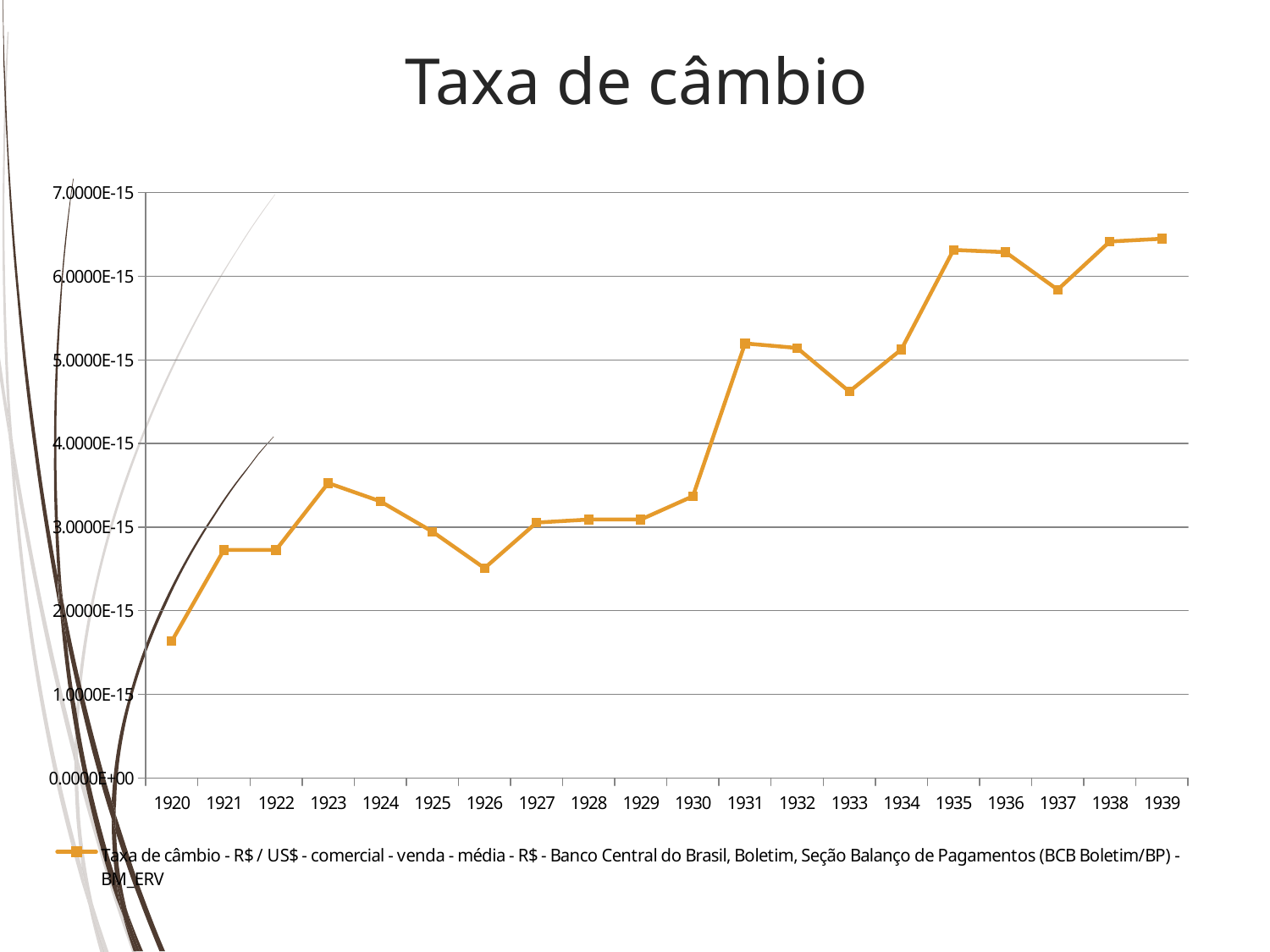
What is the title of the chart? Taxa de câmbio Is the value for 1935 greater or less than 6.0000E-15? greater How many years are plotted along the x axis? 20 Which is larger, the value for 1925 or the value for 1926? 1925 Is the value for 1926 greater or less than 3.0000E-15? less Is the value for 1931 greater or less than 5.0000E-15? greater Overall, do the values rise or fall from 1920 to 1939? rise How many series does the legend list? 1 What kind of chart is shown on the slide? line chart Which is larger, the value for 1930 or the value for 1931? 1931 Which year has the lowest value? 1920